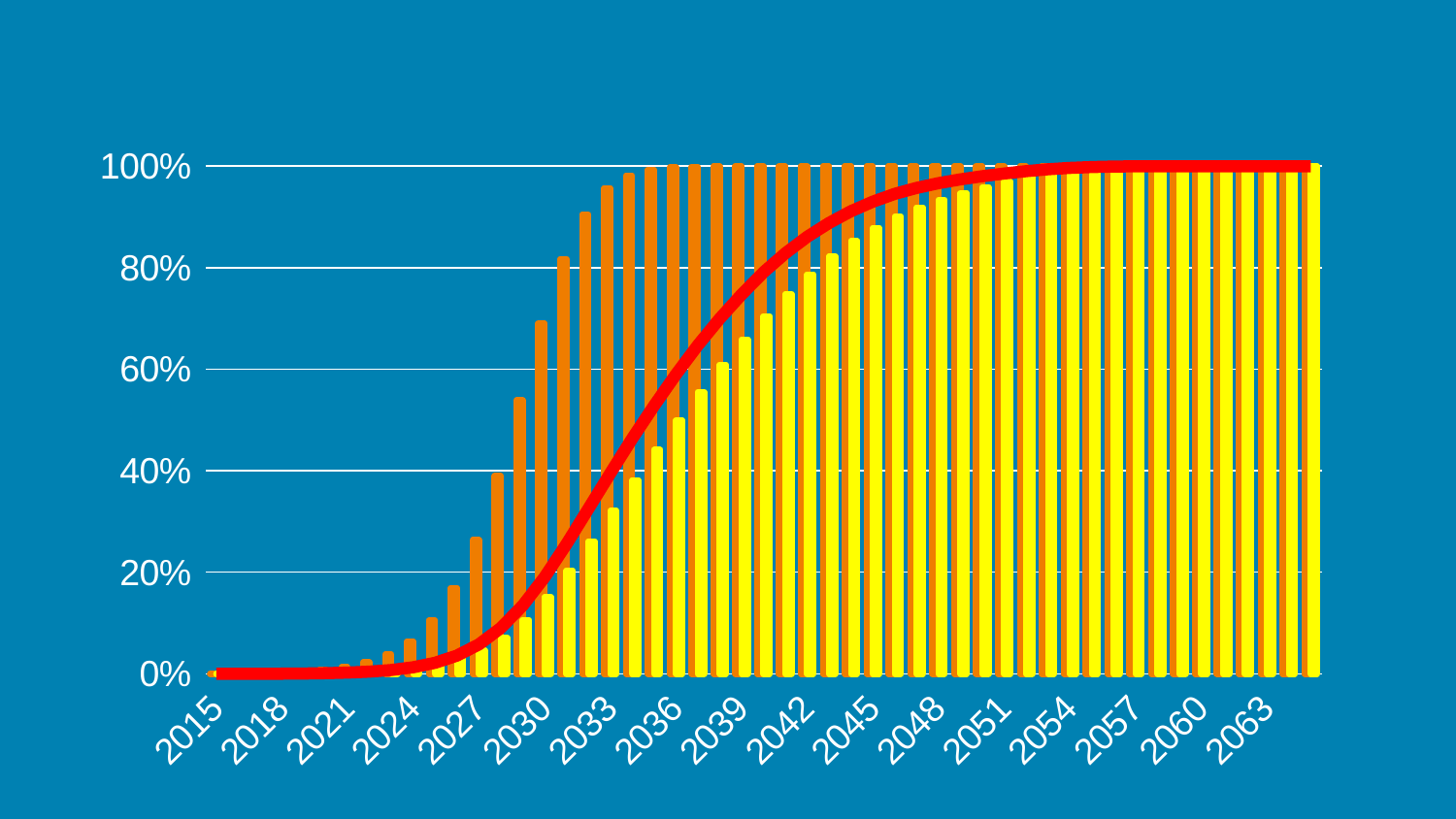
Is the value of the yellow bar for 2030 greater or less than 20%? less Is the value of the red line at 2027 greater or less than 20%? less Do the values of the bars rise or fall as the years increase along the x axis? Rise Is the value of the orange bar for 2024 greater or less than 20%? less How many year labels are shown on the x axis? 17 What is the highest value shown on the y axis? 100% At 2030, which is larger: the orange bar or the yellow bar? The orange bar What kind of chart is shown on the slide? A bar chart with a line overlaid